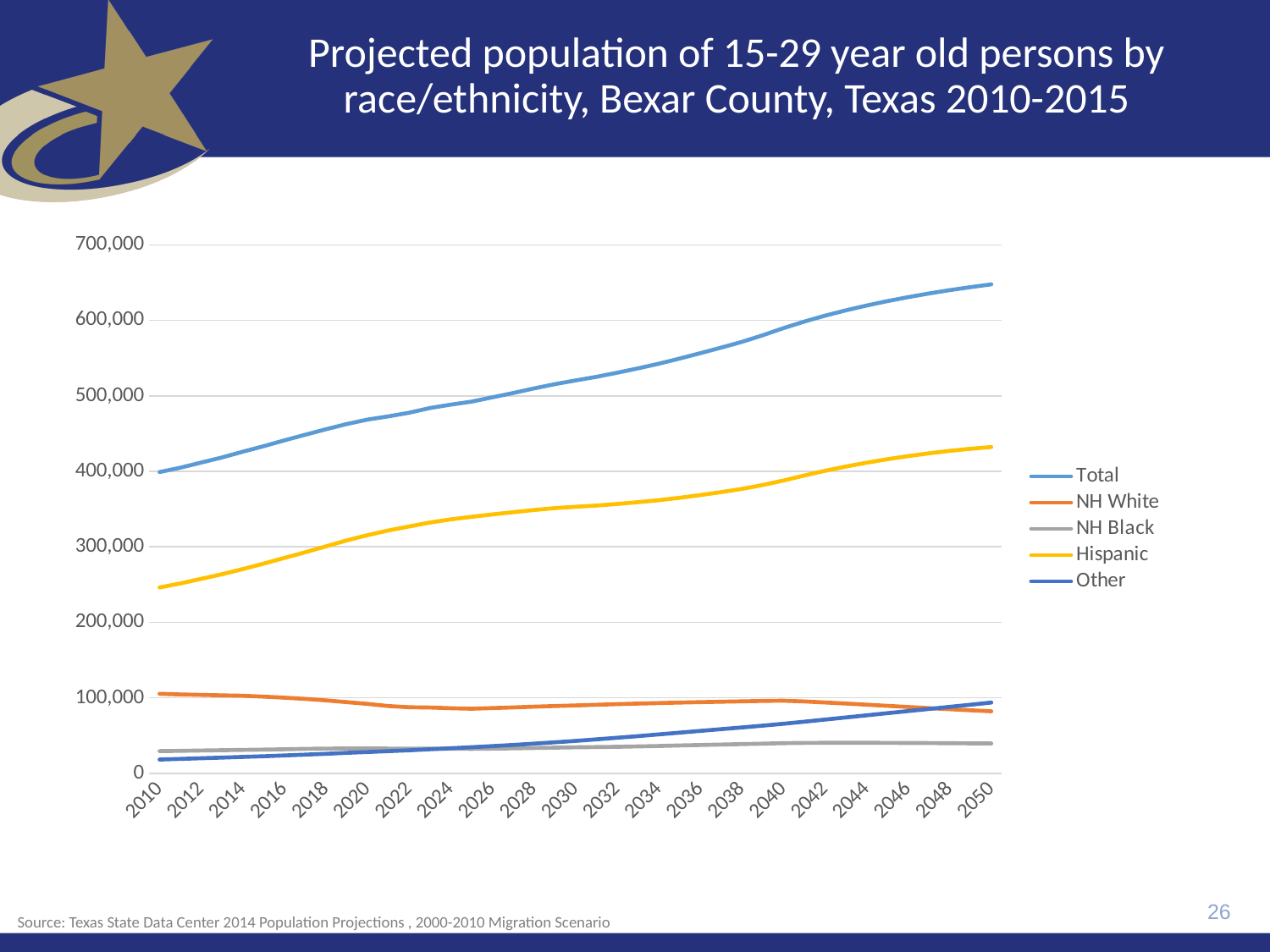
Is the value for Total in 2010 greater or less than 300,000? greater In 2030, which is larger, the Hispanic value or the NH White value? Hispanic Does the Total line rise or fall from 2010 to 2050? rise Is the value for Hispanic in 2050 greater or less than 400,000? greater Which series is drawn in yellow? Hispanic What kind of chart is shown on the slide? line chart How many year labels are shown along the x axis? 21 How many series does the legend list? 5 Which series has the highest value in 2050? Total Does the NH White line rise or fall from 2010 to 2050? fall Is the value for NH Black in 2050 greater or less than 100,000? less Which series has the lowest value in 2010? Other